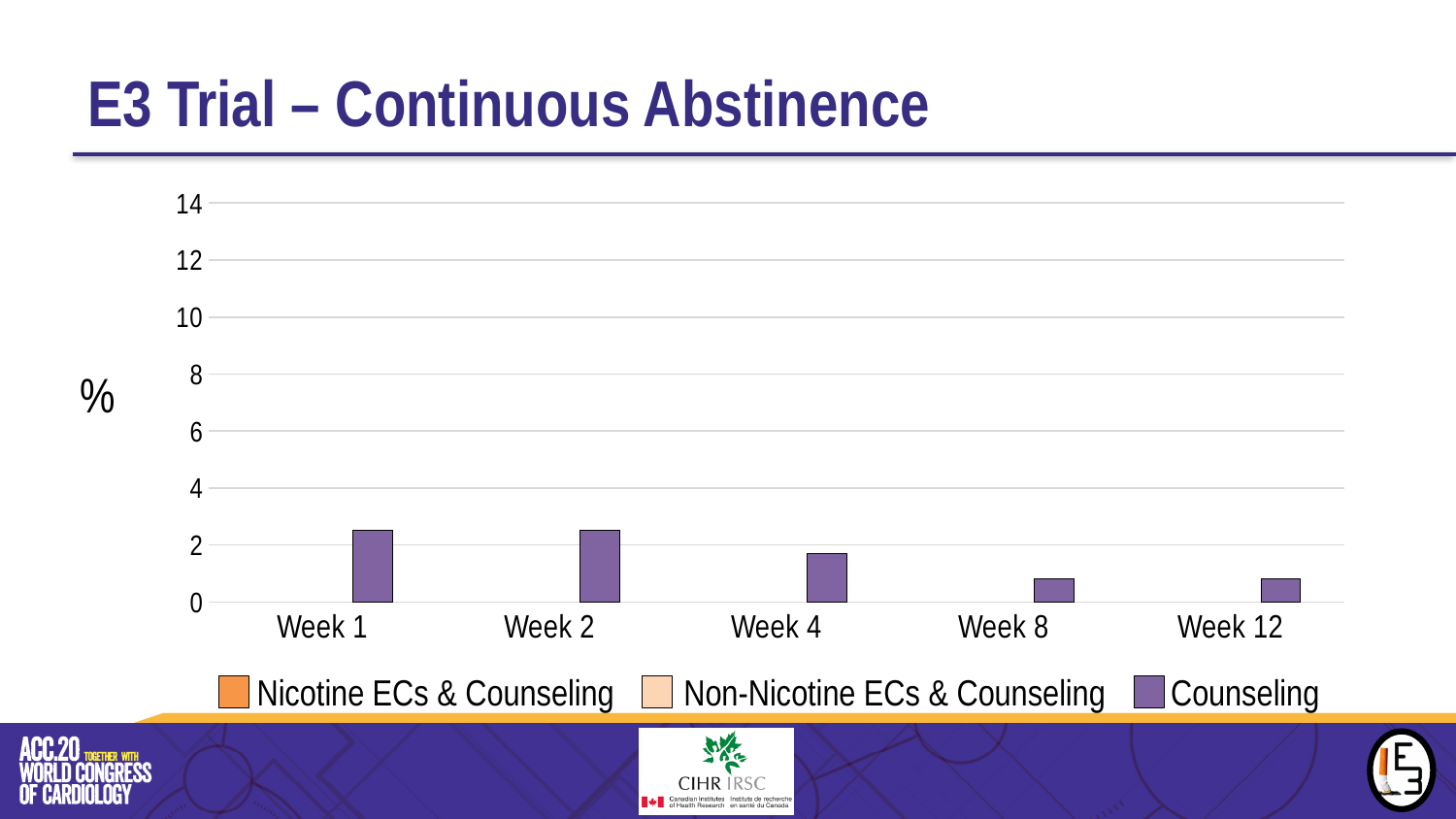
Which series is shown in purple in the legend? Counseling Is the Counseling value for Week 4 greater or less than 2? less Is the Counseling value for Week 12 greater or less than 4? less What kind of chart is shown on the slide? bar chart Do the Counseling values rise or fall from Week 1 to Week 12? fall What is the title of the chart on the slide? E3 Trial – Continuous Abstinence Which is larger for the Counseling series, the value for Week 2 or the value for Week 4? Week 2 Is the Counseling value for Week 8 greater or less than 2? less Which is larger for the Counseling series, the value for Week 1 or the value for Week 8? Week 1 How many series does the legend list? 3 How many week categories are shown on the x axis? 5